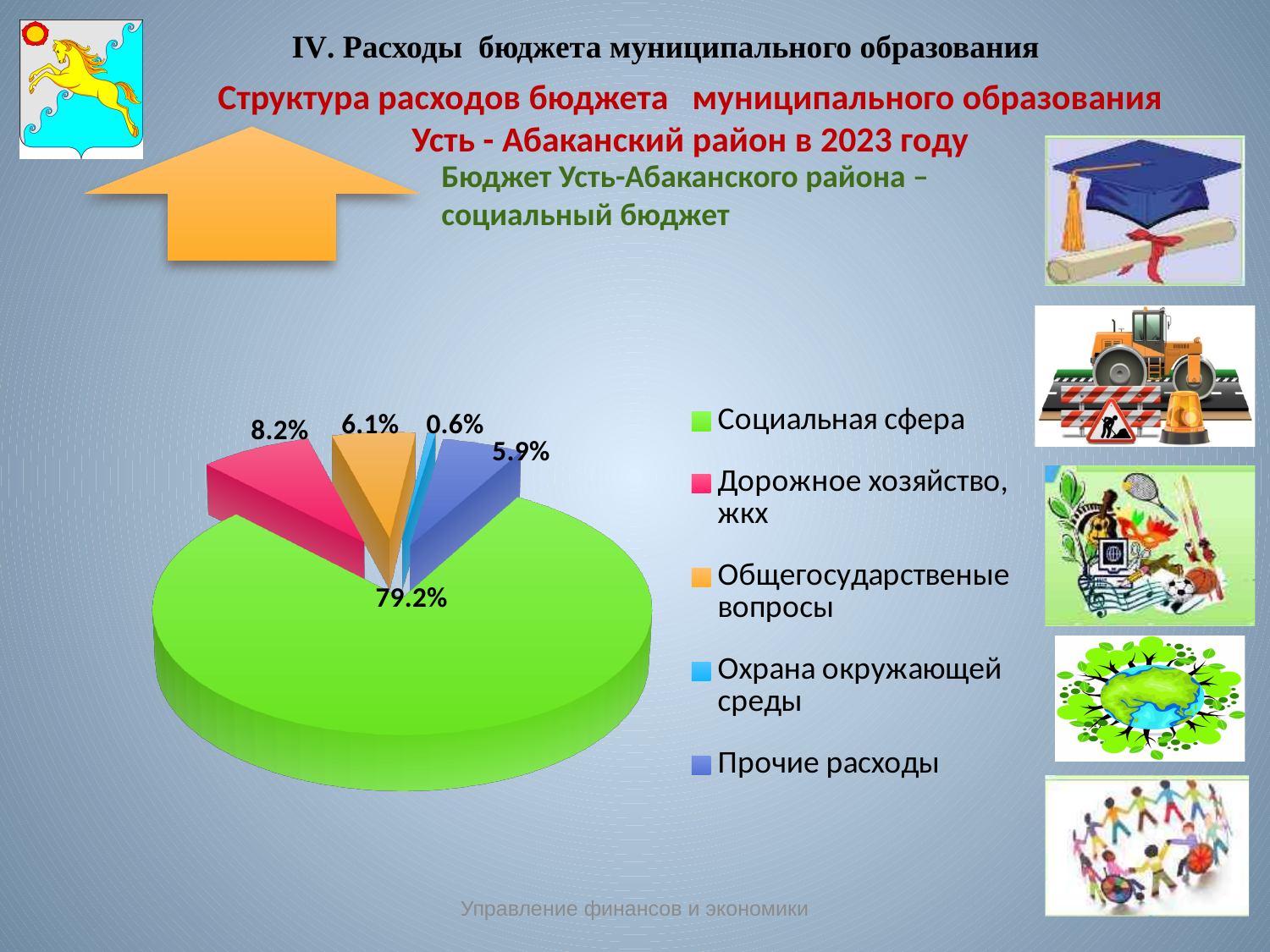
Which category has the smallest slice of the pie? Охрана окружающей среды What is the value for Охрана окружающей среды? 0.6% What colour is the slice for Социальная сфера? green What is the difference between the values for Социальная сфера and Дорожное хозяйство, жкх? 71.0 percentage points What kind of chart is shown on the slide? pie chart What is the value for Общегосударственые вопросы? 6.1% How many categories does the pie chart have? 5 What share of the pie does Социальная сфера have? 79.2% What is the value for Дорожное хозяйство, жкх? 8.2% Which category has the largest slice of the pie? Социальная сфера Which is larger, Общегосударственые вопросы or Прочие расходы? Общегосударственые вопросы What is the value for Прочие расходы? 5.9%